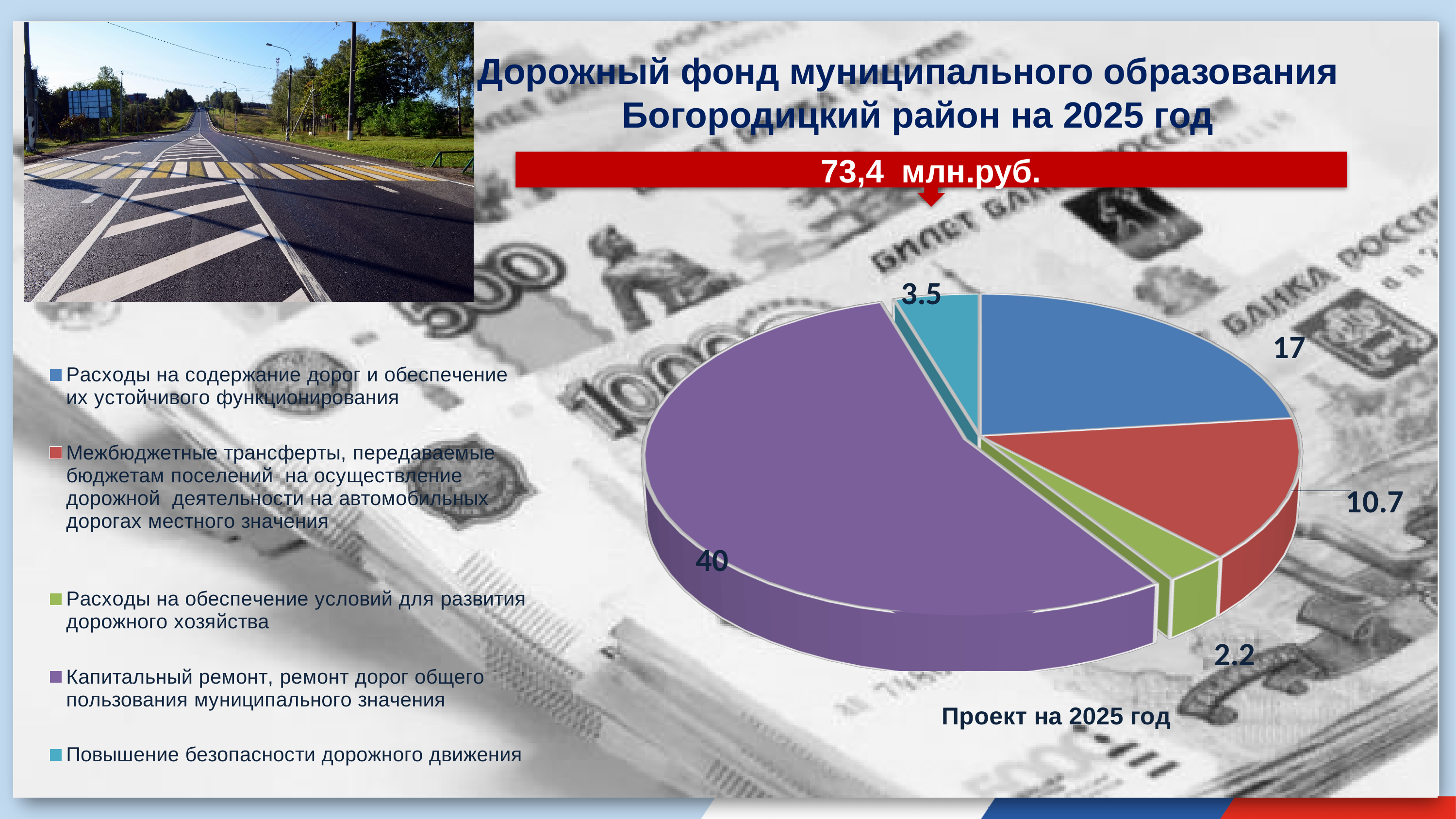
How many slices does the pie chart have? 5 Which category has the largest slice of the pie chart? Капитальный ремонт, ремонт дорог общего пользования муниципального значения Which is larger: the value for "Повышение безопасности дорожного движения" or the value for "Расходы на обеспечение условий для развития дорожного хозяйства"? Повышение безопасности дорожного движения What is the value for "Капитальный ремонт, ремонт дорог общего пользования муниципального значения"? 40 What kind of chart is shown on the slide? pie chart How many entries does the legend of the pie chart list? 5 What is the value for "Расходы на содержание дорог и обеспечение их устойчивого функционирования"? 17 What is the title shown below the pie chart? Проект на 2025 год What is the difference between the value for "Расходы на содержание дорог и обеспечение их устойчивого функционирования" and the value for "Межбюджетные трансферты, передаваемые бюджетам поселений на осуществление дорожной деятельности на автомобильных дорогах местного значения"? 6.3 What is the value for "Межбюджетные трансферты, передаваемые бюджетам поселений на осуществление дорожной деятельности на автомобильных дорогах местного значения"? 10.7 What is the value for "Повышение безопасности дорожного движения"? 3.5 Which category has the smallest slice of the pie chart? Расходы на обеспечение условий для развития дорожного хозяйства